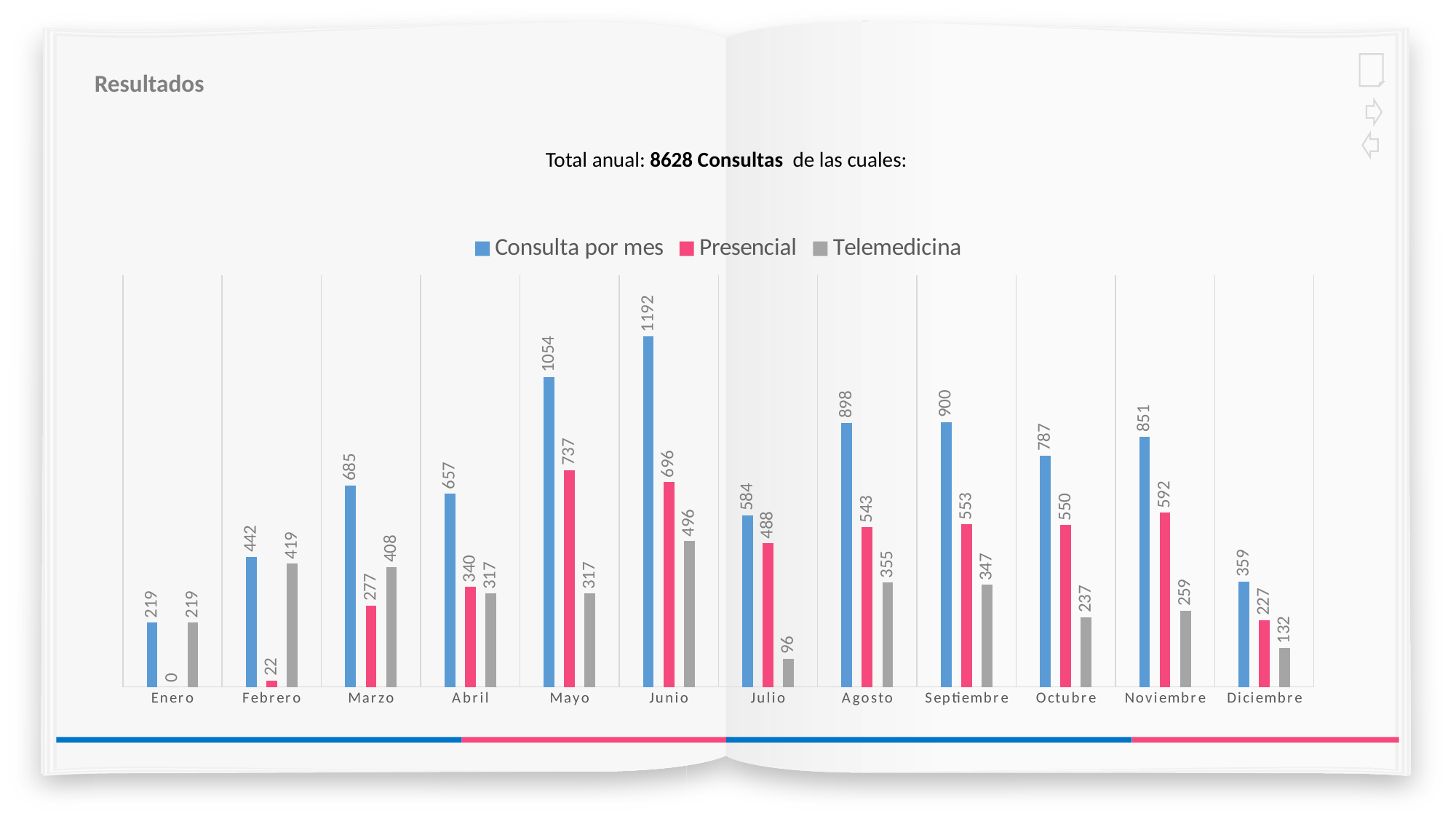
What kind of chart is shown on the slide? Bar chart How many months are shown on the x axis? 12 Which month has the lowest Presencial value? Enero What is the value of Consulta por mes for Junio? 1192 What is the Presencial value for Mayo? 737 Which month has the highest Consulta por mes value? Junio Does the Telemedicina value rise or fall from Septiembre to Diciembre? Fall Which is larger, the Telemedicina value for Marzo or for Abril? Marzo What annual total of consultations is stated on the slide? 8628 Consultas How many series does the legend list? 3 What is the difference between the Consulta por mes values for Mayo and Junio? 138 What is the Telemedicina value for Febrero? 419